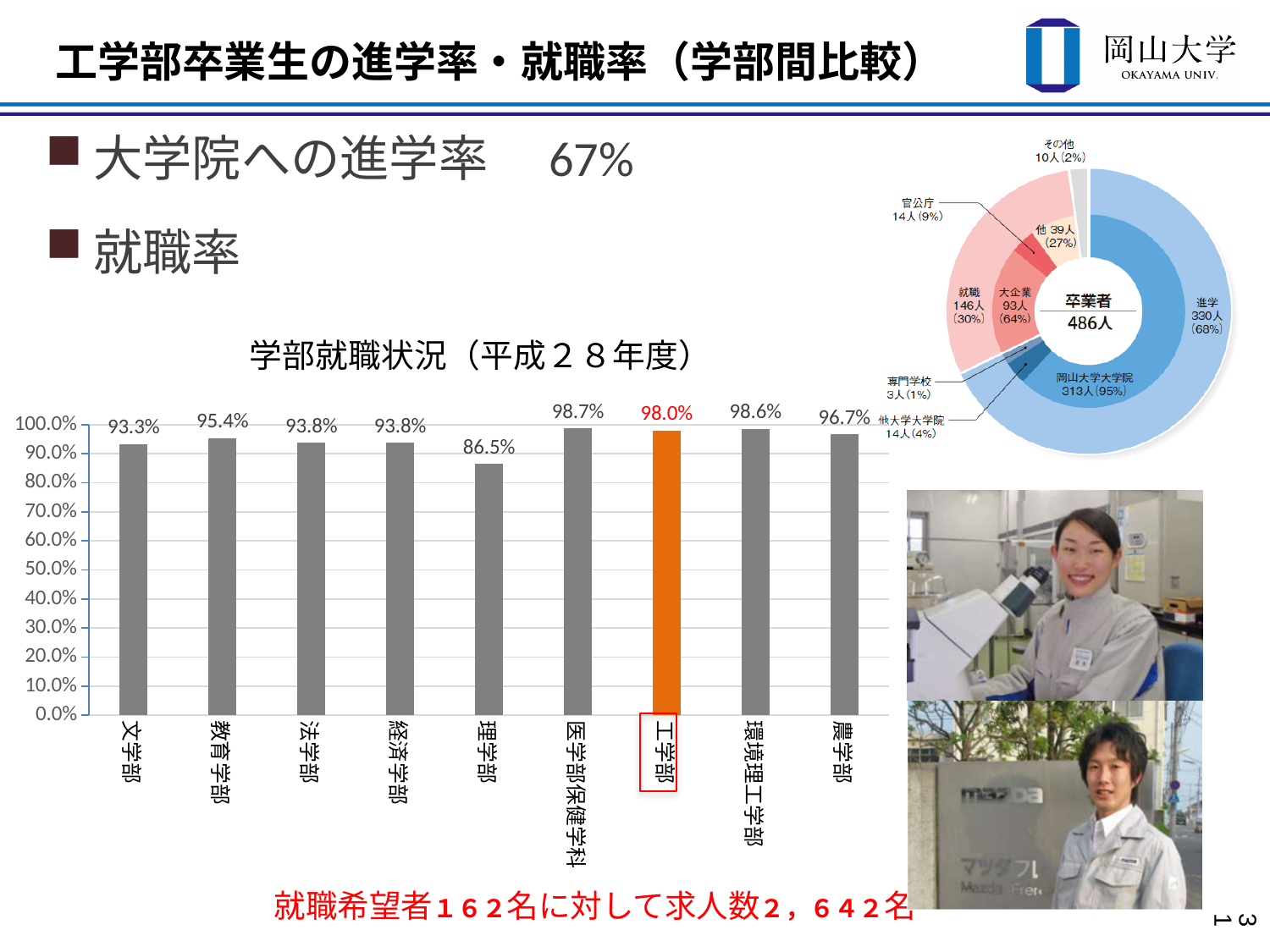
In the bar chart 学部就職状況（平成２８年度）, what is the difference between the values for 工学部 and 理学部? 11.5 percentage points In the bar chart 学部就職状況（平成２８年度）, which is higher, 教育学部 or 文学部? 教育学部 In the donut chart on the right, how many graduates (卒業者) are shown in the centre? 486人 In the donut chart on the right, what share of graduates went on to further study (進学)? 68% In the bar chart 学部就職状況（平成２８年度）, what is the value for 理学部? 86.5% In the bar chart 学部就職状況（平成２８年度）, is the value for 理学部 greater or less than 90.0%? less In the bar chart 学部就職状況（平成２８年度）, which faculty has the lowest employment rate? 理学部 What kind of chart is 学部就職状況（平成２８年度）? bar chart In the bar chart 学部就職状況（平成２８年度）, what is the employment rate for 工学部? 98.0% In the bar chart 学部就職状況（平成２８年度）, what is the value for 農学部? 96.7% How many faculties are shown in the bar chart 学部就職状況（平成２８年度）? 9 In the bar chart 学部就職状況（平成２８年度）, which bar is highlighted in orange? 工学部